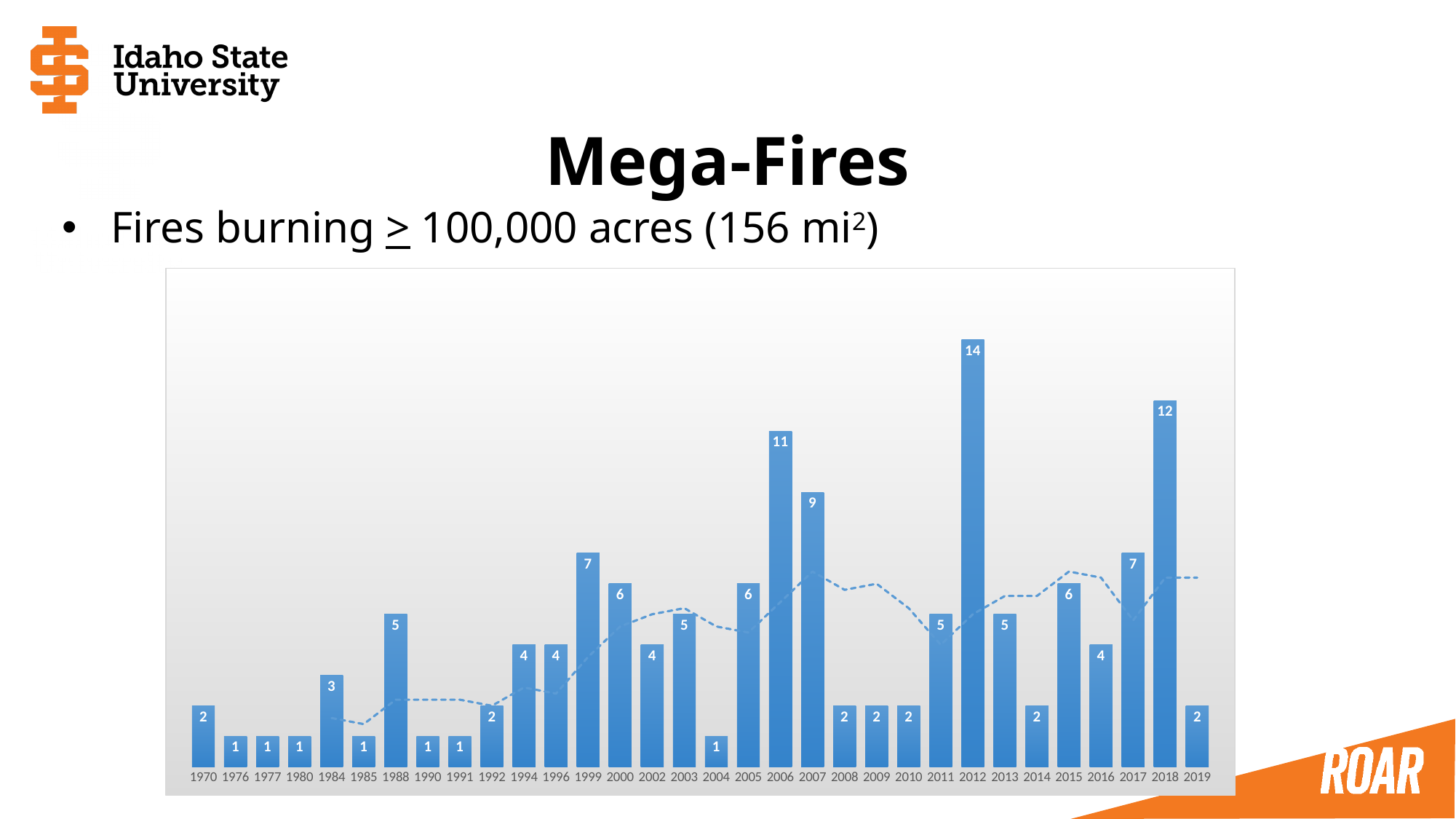
What value is shown for 2019? 2 Which is larger, the value for 2015 or the value for 2016? 2015 What is the difference between the values for 2006 and 2007? 2 What is the lowest value shown on any bar? 1 How many years (bars) are shown on the x axis? 32 Which is larger, the value for 1999 or the value for 2000? 1999 How many mega-fires does the chart show for 2012? 14 Which year has the highest bar? 2012 What is the difference between the values for 2012 and 2018? 2 What kind of chart is shown on the slide? Bar chart What value is shown for 1988? 5 What value is shown for 2006? 11